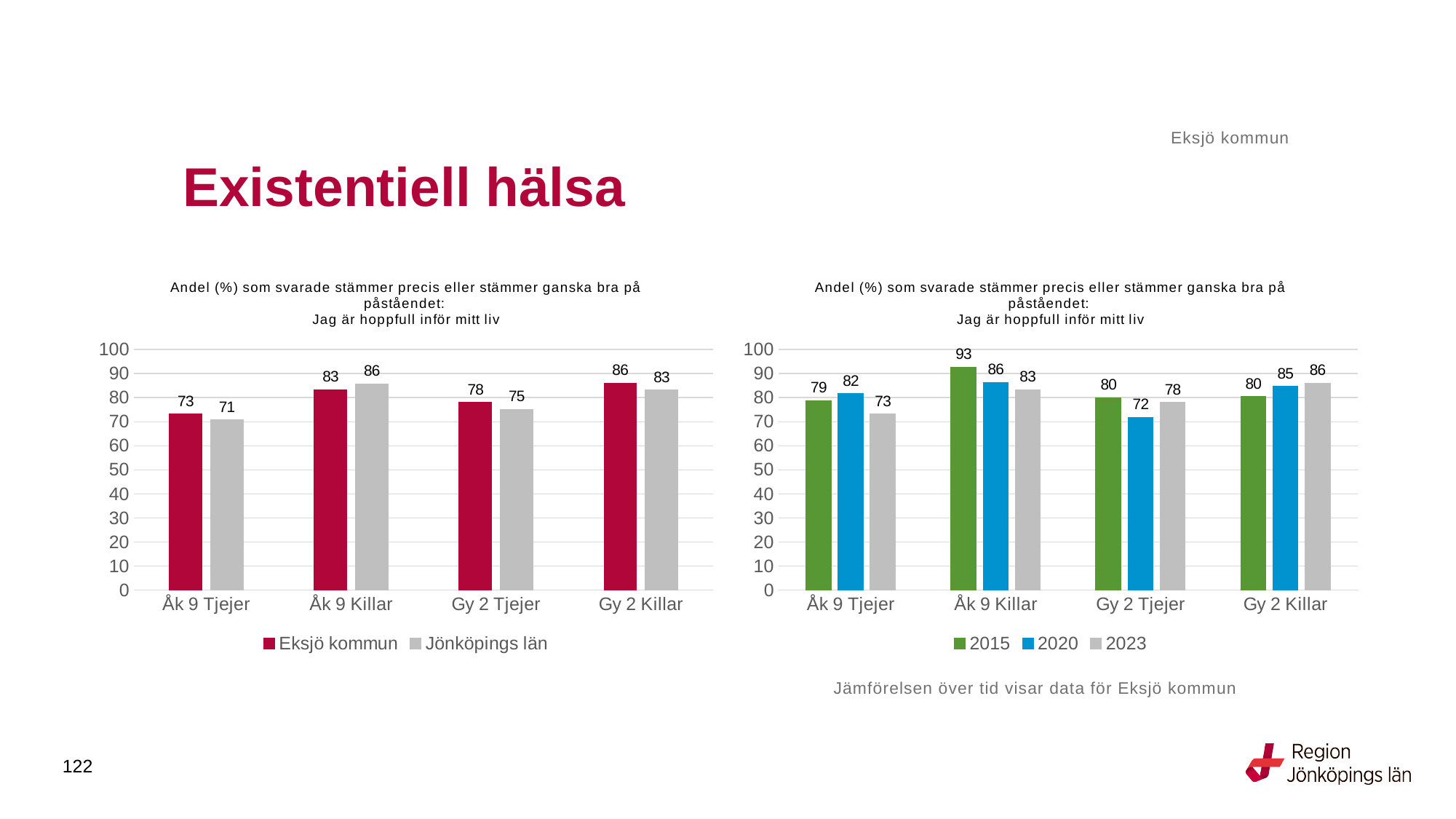
In the right chart, what is the value for 2020 for Gy 2 Tjejer? 72 In the right chart, what is the difference between the 2015 and 2023 values for Åk 9 Killar? 10 In the left chart, which category has the lowest Jönköpings län value? Åk 9 Tjejer In the left chart, what is the difference between Eksjö kommun and Jönköpings län for Åk 9 Killar? 3 In the left chart, which category has the highest Eksjö kommun value? Gy 2 Killar In the right chart, which is larger for Åk 9 Tjejer: 2015 or 2023? 2015 What type of chart is the right chart? Bar chart In the left chart, what is the value for Jönköpings län for Gy 2 Killar? 83 In the right chart, how many categories are shown on the x axis? 4 In the right chart, what is the value for 2015 for Åk 9 Killar? 93 In the left chart, how many series does the legend list? 2 In the left chart, what is the value for Eksjö kommun for Åk 9 Tjejer? 73